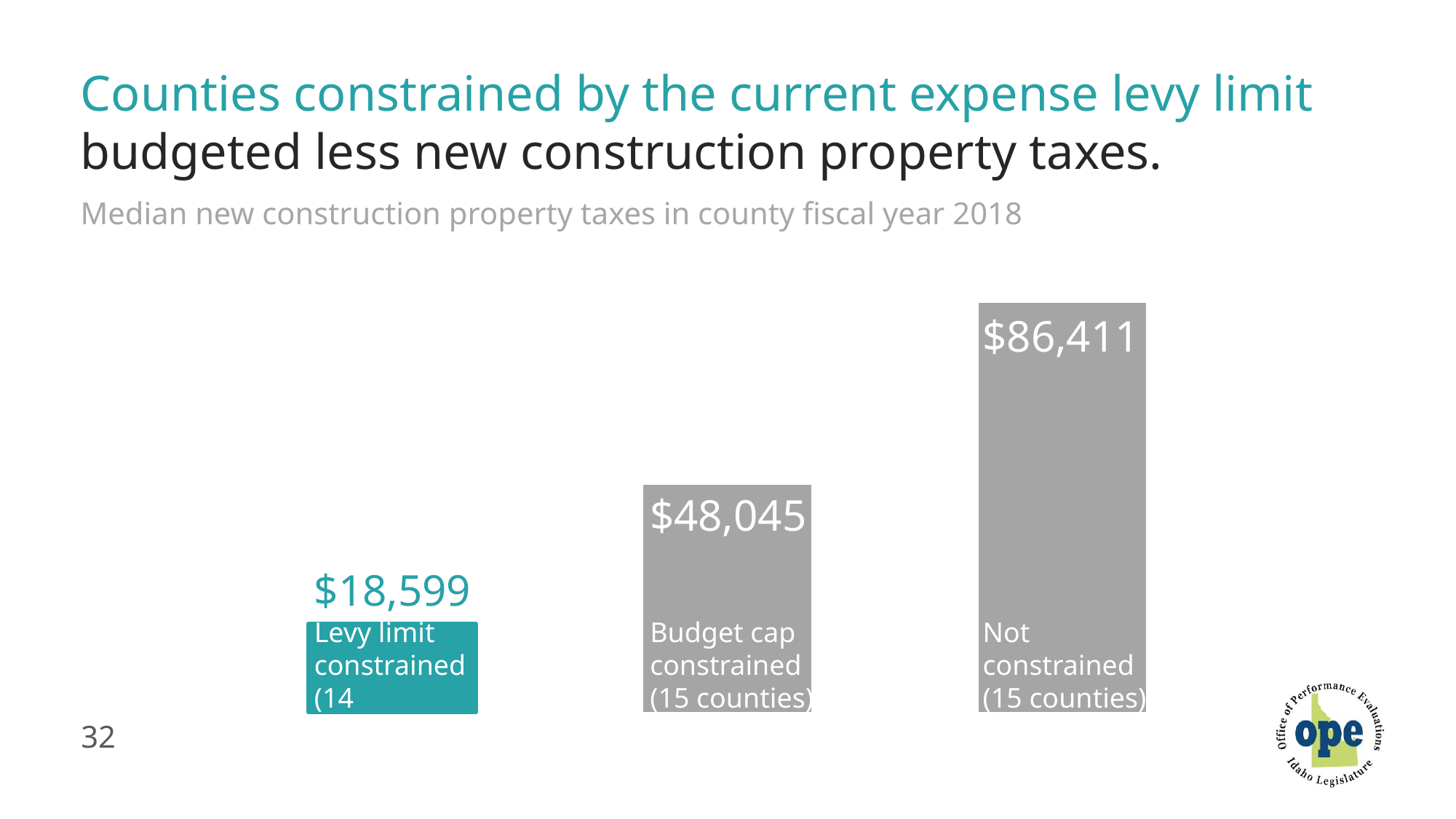
Which category has the highest median new construction property taxes? Not constrained Which is larger, the median for budget cap constrained counties or for not constrained counties? Not constrained Do the values rise or fall from left to right across the categories? Rise What is the difference between the budget cap constrained and levy limit constrained medians? $29,446 Which bar is coloured teal rather than grey? Levy limit constrained What kind of chart is shown on the slide? Bar chart What is the median new construction property tax for not constrained counties? $86,411 Which category has the lowest median new construction property taxes? Levy limit constrained How many categories are shown in the chart? 3 What is the median new construction property tax for levy limit constrained counties? $18,599 What is the difference between the not constrained and levy limit constrained medians? $67,812 What is the median new construction property tax for budget cap constrained counties? $48,045